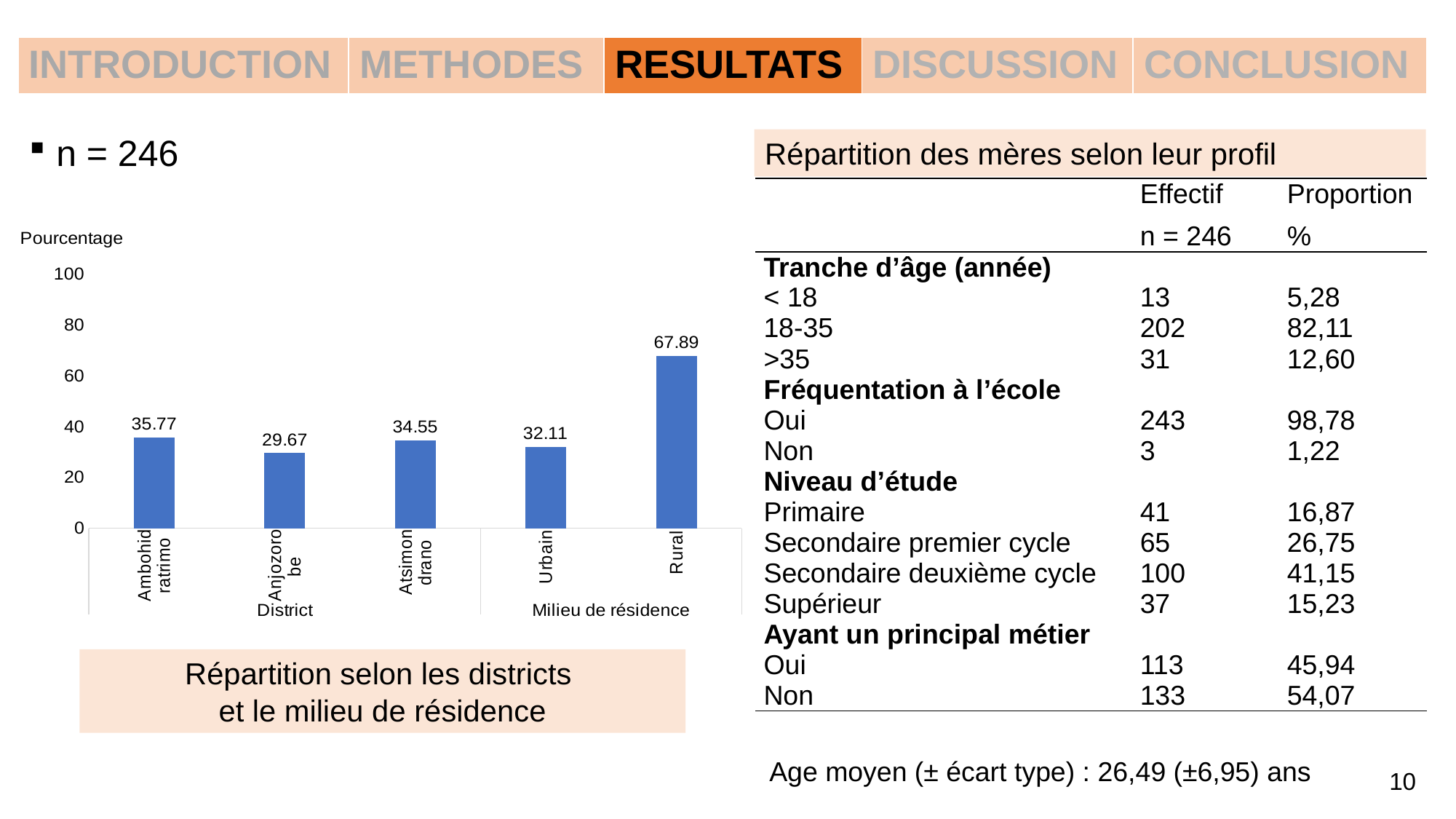
What is the difference between the values for Ambohidratrimo and Atsimondrano in the bar chart? 1.22 What is the value for Anjozorobe in the bar chart? 29.67 What is the value for Ambohidratrimo in the bar chart? 35.77 What is the difference between the values for Rural and Urbain in the bar chart? 35.78 Which is larger in the bar chart, the value for Ambohidratrimo or the value for Anjozorobe? Ambohidratrimo Is the value for Rural in the bar chart greater or less than 60? greater What is the value for Urbain in the bar chart? 32.11 What is the value for Rural in the bar chart? 67.89 How many bars are shown in the bar chart? 5 What type of chart is shown on the slide? Bar chart Which category has the lowest value in the bar chart? Anjozorobe Which category has the highest value in the bar chart? Rural